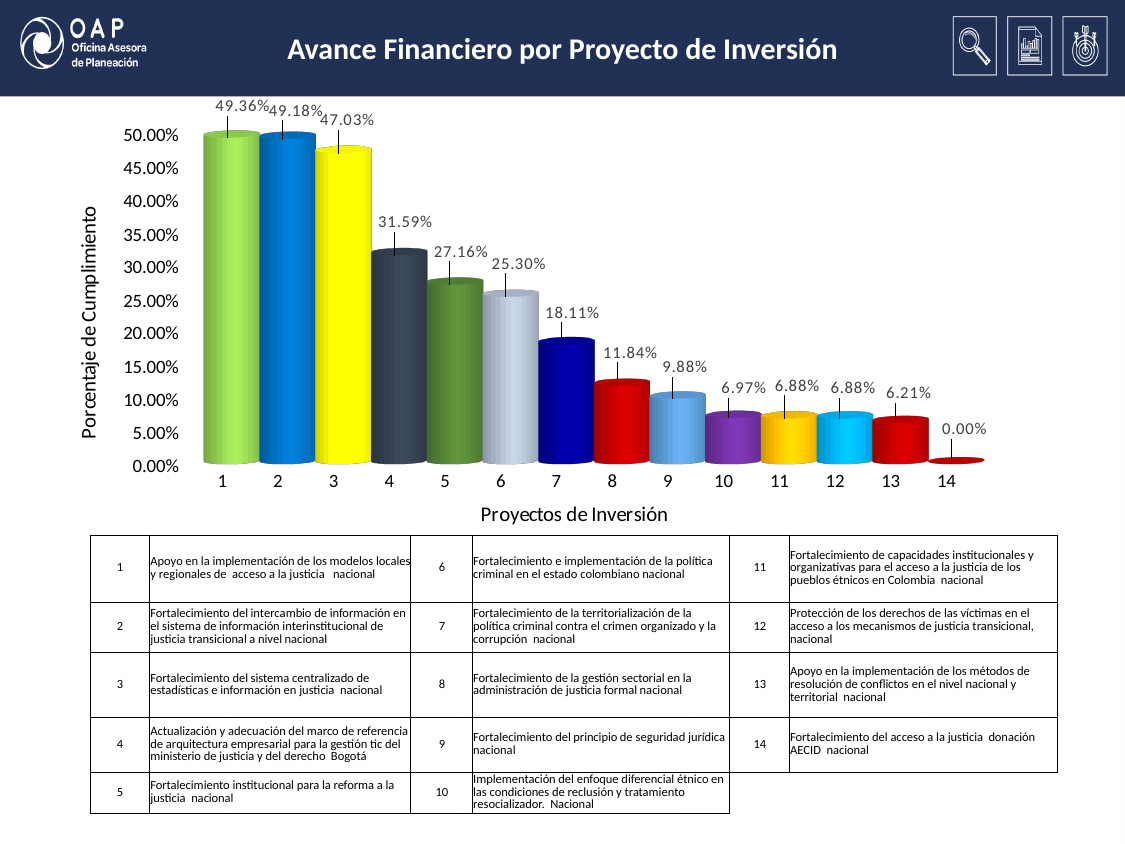
What kind of chart is shown on the slide? Bar chart What is the label of the vertical axis of the chart? Porcentaje de Cumplimiento Which has a larger value, project 6 or project 9? Project 6 What is the difference between the values for project 7 and project 8? 6.27% What is the difference between the values for project 4 and project 5? 4.43% What is the value for project 4 in the chart? 31.59% Do the values rise or fall from project 1 to project 14? Fall What is the value for project 7 in the chart? 18.11% What is the value for project 13 in the chart? 6.21% How many projects are plotted in the chart? 14 Which project has the lowest value in the chart? 14 Which project has the highest value in the chart? 1